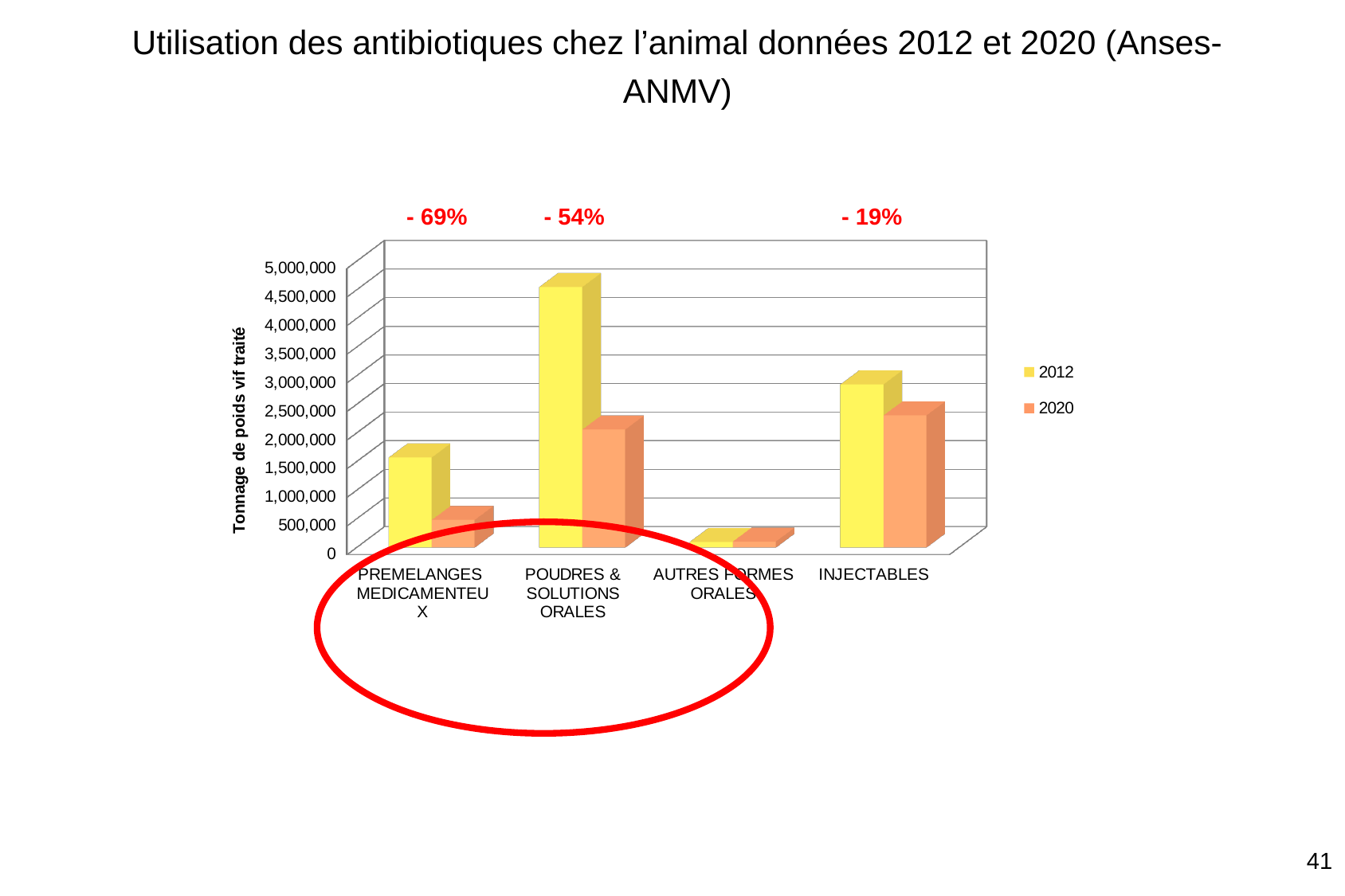
What percentage change is annotated above the PREMELANGES MEDICAMENTEUX bars? - 69% How many categories are shown on the x axis? 4 Which category has the lowest value for 2012? AUTRES FORMES ORALES Is the 2012 value for POUDRES & SOLUTIONS ORALES greater or less than 4,000,000? greater Is the 2020 value for PREMELANGES MEDICAMENTEUX greater or less than 1,000,000? less Is the 2012 value for AUTRES FORMES ORALES greater or less than 500,000? less What kind of chart is shown on the slide? bar chart How many series does the legend list? 2 Which category has the highest value for 2012? POUDRES & SOLUTIONS ORALES What is the title of the vertical axis? Tonnage de poids vif traité Which is larger: the 2020 value for INJECTABLES or the 2020 value for PREMELANGES MEDICAMENTEUX? INJECTABLES